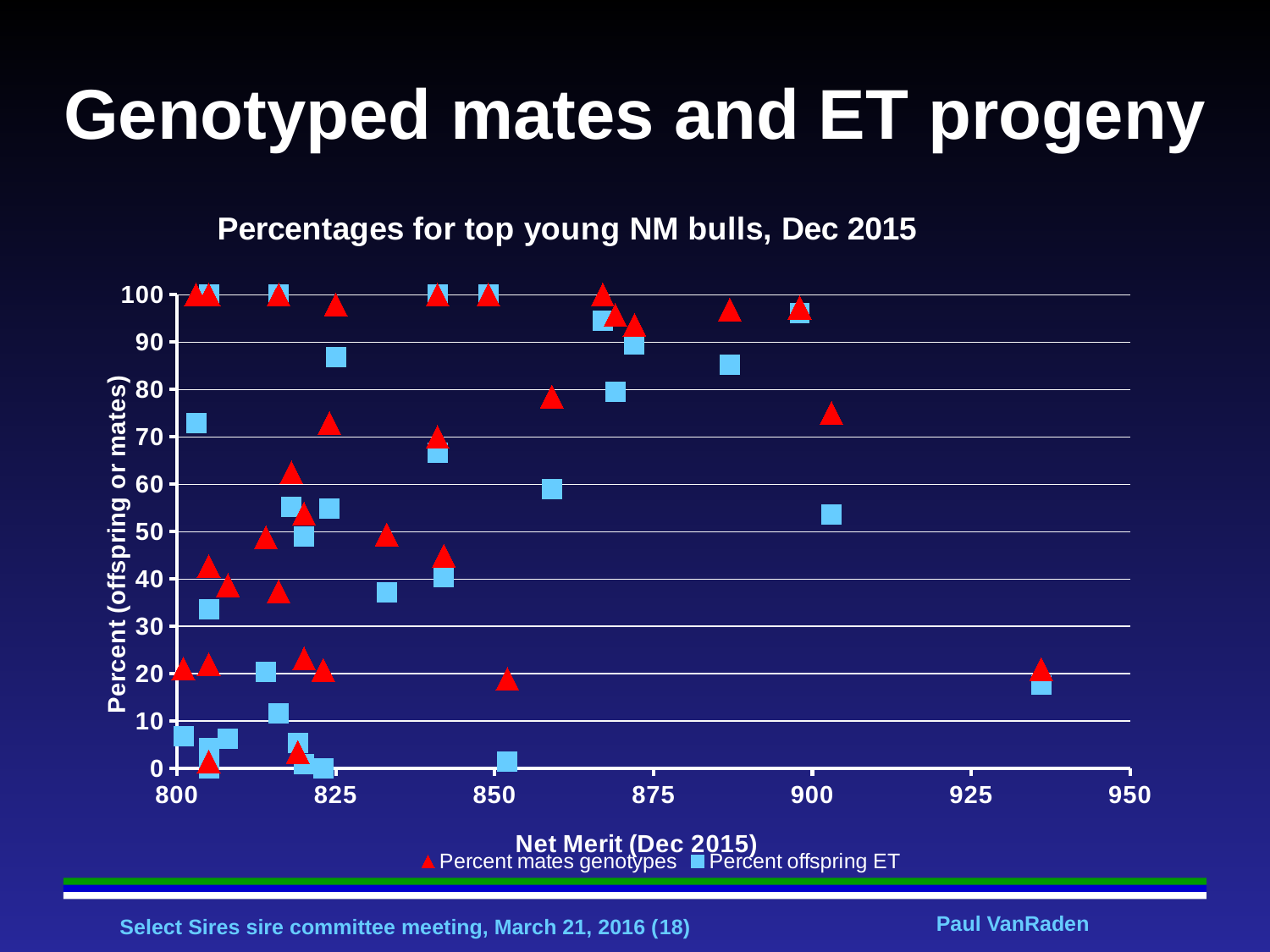
Is the Percent offspring ET value for the rightmost point (near Net Merit 936) greater or less than 30? less How many series does the legend list? 2 Is the Percent offspring ET value for the point near Net Merit 887 greater or less than 80? greater Is the Percent mates genotypes value for the point near Net Merit 903 greater or less than 60? greater What kind of chart is shown on the slide? scatter chart What is the title of the chart? Percentages for top young NM bulls, Dec 2015 What are the two series named in the legend? Percent mates genotypes; Percent offspring ET